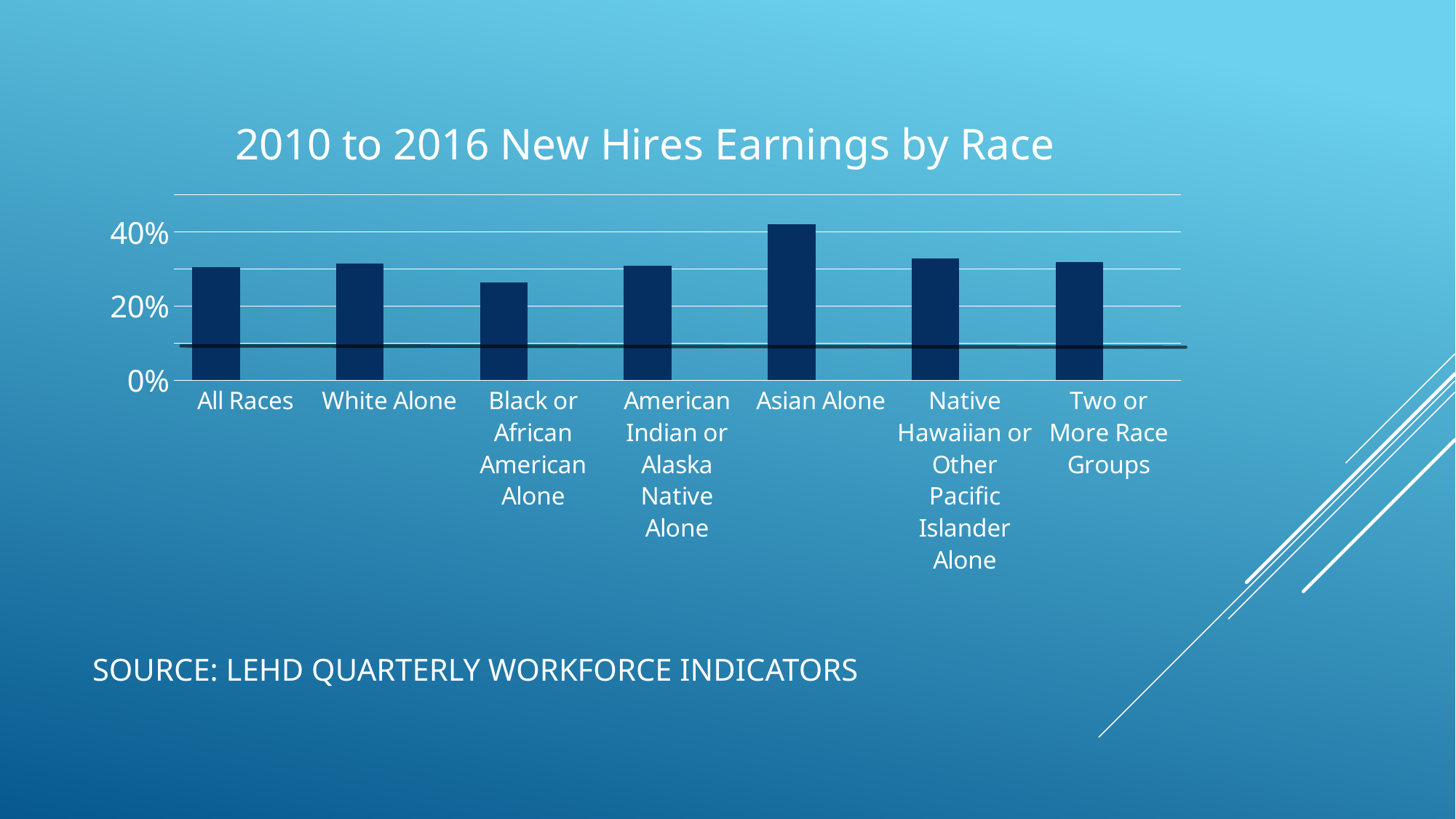
Is the value for Black or African American Alone greater or less than 40%? less Which category has the highest bar? Asian Alone Which is larger, the value for White Alone or the value for Black or African American Alone? White Alone Is the value for All Races greater or less than 20%? greater Is the value for Asian Alone greater or less than 40%? greater What source is cited below the chart? LEHD Quarterly Workforce Indicators How many race categories are plotted on the x axis? 7 Which category has the lowest bar? Black or African American Alone What is the title of the chart? 2010 to 2016 New Hires Earnings by Race What kind of chart is shown on the slide? bar chart Which is larger, the value for Asian Alone or the value for White Alone? Asian Alone